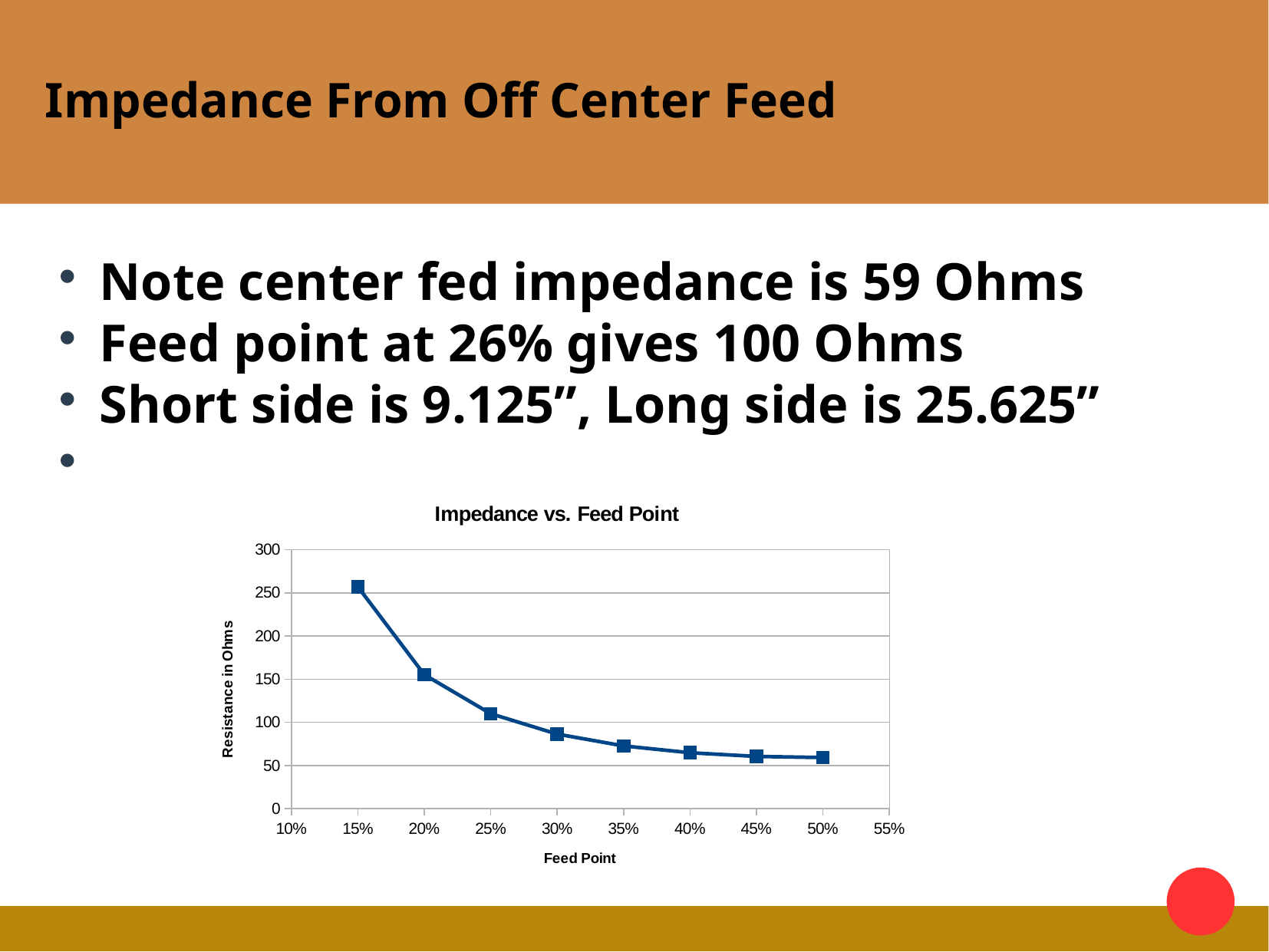
Is the resistance at a 15% feed point greater or less than 200? greater What kind of chart is shown on the slide? line chart At which feed point is the resistance highest? 15% Do the plotted values rise or fall as the feed point increases from 15% to 50%? fall What is the label of the vertical axis of the chart? Resistance in Ohms How many data points are plotted on the chart? 8 Which feed point has the larger resistance, 15% or 20%? 15% Is the resistance at a 30% feed point greater or less than 100? less Is the resistance at a 20% feed point greater or less than 200? less Which feed point has the larger resistance, 25% or 35%? 25% What is the title of the chart? Impedance vs. Feed Point